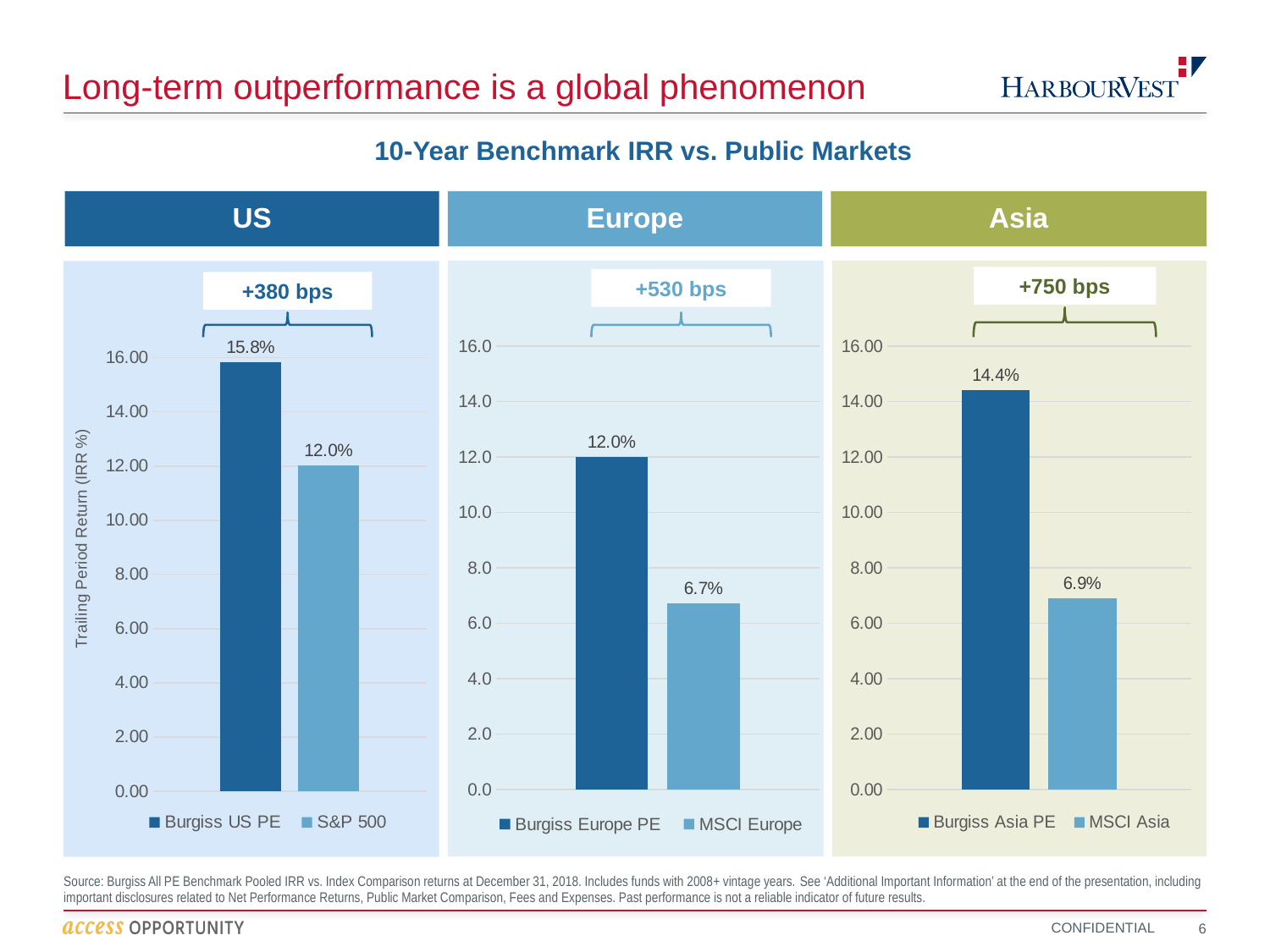
How many series does the legend of the Europe chart list? 2 In the US chart, what is the value for Burgiss US PE? 15.8% In the Asia chart, what is the difference between Burgiss Asia PE and MSCI Asia? 7.5% What outperformance in bps is shown above the Europe chart? +530 bps In the Europe chart, which series has the higher value? Burgiss Europe PE In the Asia chart, what is the value for Burgiss Asia PE? 14.4% In the Asia chart, what is the value for MSCI Asia? 6.9% In the Europe chart, what is the value for MSCI Europe? 6.7% What is the title shown above the three charts? 10-Year Benchmark IRR vs. Public Markets In the US chart, is the value for Burgiss US PE greater or less than 14.00? greater What kind of chart is the Asia chart? bar chart In the US chart, what is the value for S&P 500? 12.0%